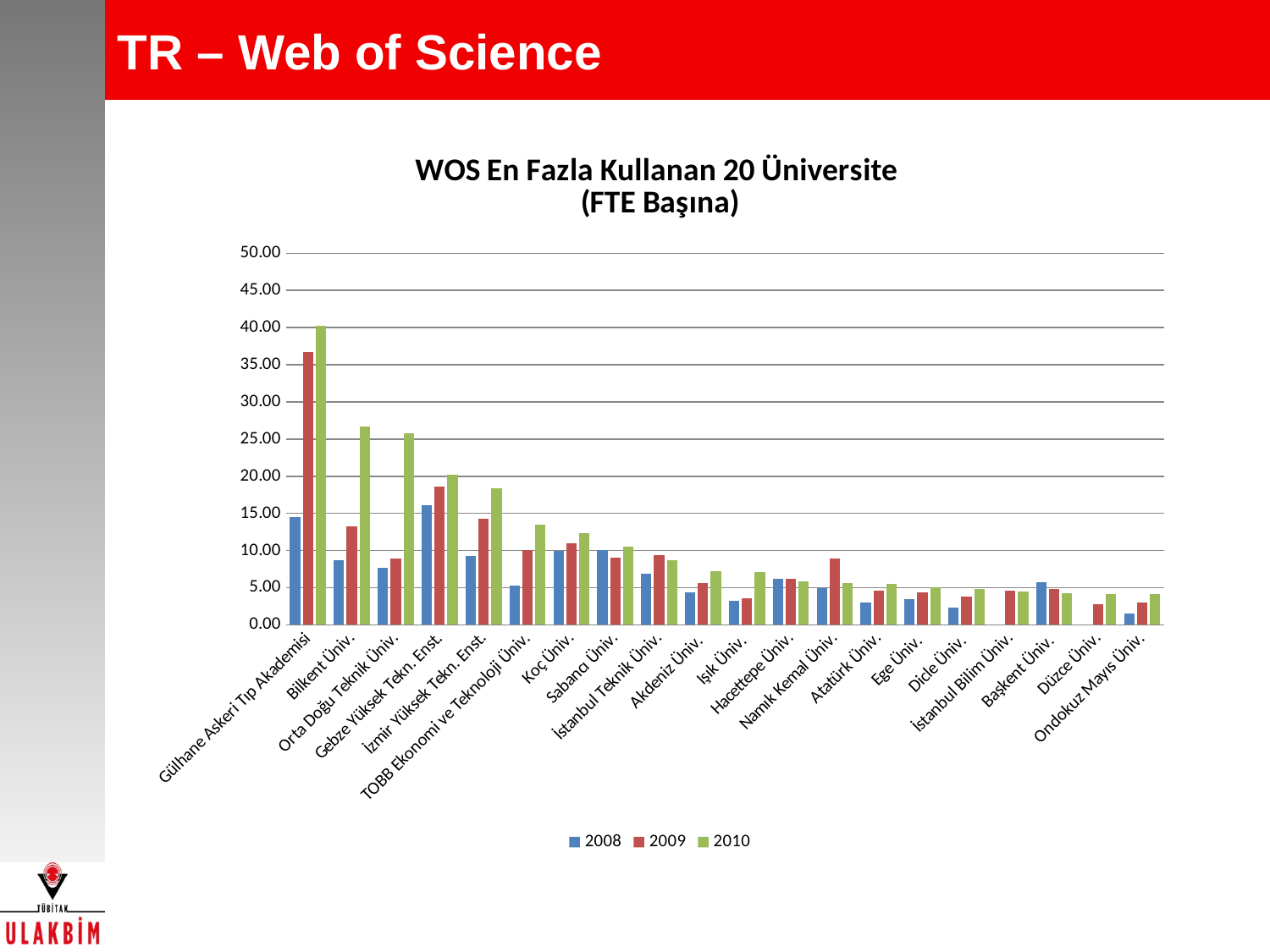
Do the 2010 values generally rise or fall from left to right along the x axis? fall Is the 2010 value for Gülhane Askeri Tıp Akademisi greater or less than 35.00? greater Is the 2010 value for Koç Üniv. greater or less than 10.00? greater Which university has the highest 2010 value? Gülhane Askeri Tıp Akademisi What is the title of the chart? WOS En Fazla Kullanan 20 Üniversite (FTE Başına) How many universities are shown on the x axis? 20 Is the 2008 value for TOBB Ekonomi ve Teknoloji Üniv. greater or less than 10.00? less What kind of chart is shown on the slide? bar chart How many series does the legend list? 3 Which is larger for 2008: Gebze Yüksek Tekn. Enst. or Bilkent Üniv.? Gebze Yüksek Tekn. Enst. For Namık Kemal Üniv., which is larger: the 2009 value or the 2010 value? 2009